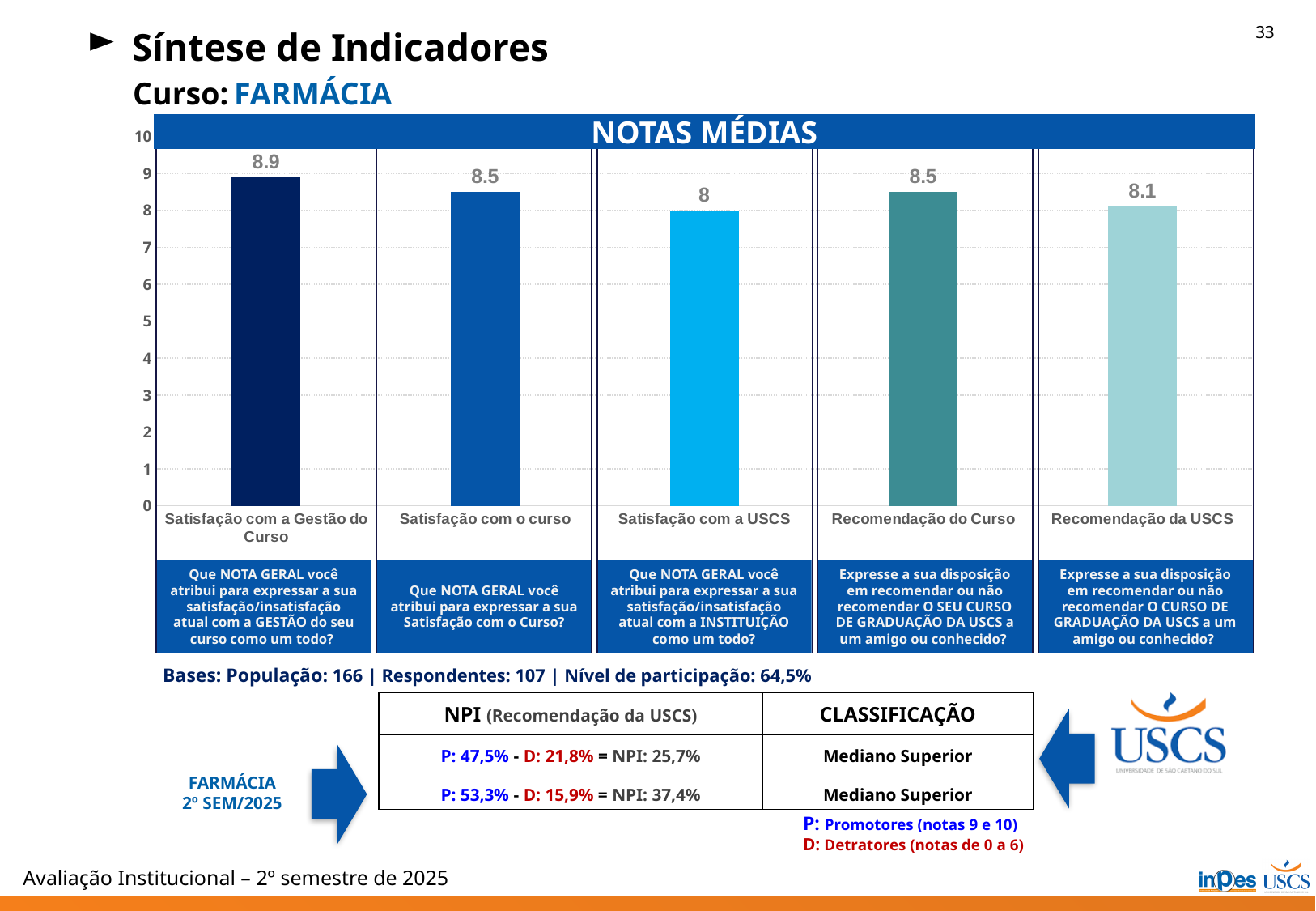
What is the title of the chart on the slide? NOTAS MÉDIAS Is the value for "Recomendação da USCS" in the NOTAS MÉDIAS chart greater or less than 9? less What is the value for "Satisfação com a USCS" in the NOTAS MÉDIAS chart? 8 Which category has the highest value in the NOTAS MÉDIAS chart? Satisfação com a Gestão do Curso What is the value for "Satisfação com a Gestão do Curso" in the NOTAS MÉDIAS chart? 8.9 How many categories are shown in the NOTAS MÉDIAS chart? 5 Which is larger in the NOTAS MÉDIAS chart: "Satisfação com o curso" or "Recomendação da USCS"? Satisfação com o curso What is the value for "Recomendação do Curso" in the NOTAS MÉDIAS chart? 8.5 Which category has the lowest value in the NOTAS MÉDIAS chart? Satisfação com a USCS What is the difference between the values for "Satisfação com a Gestão do Curso" and "Satisfação com a USCS" in the NOTAS MÉDIAS chart? 0.9 What is the value for "Recomendação da USCS" in the NOTAS MÉDIAS chart? 8.1 What kind of chart is the NOTAS MÉDIAS chart? bar chart